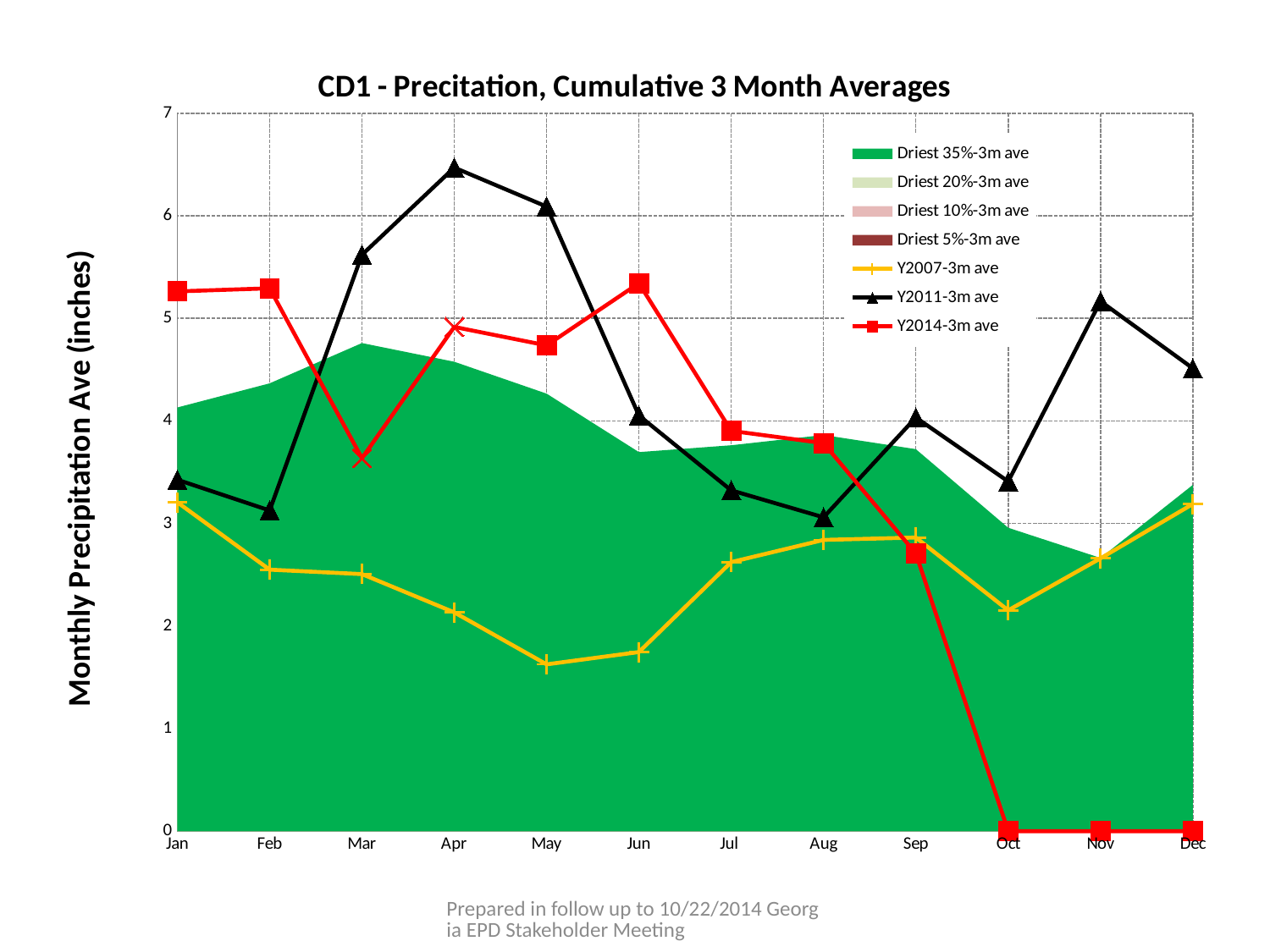
Is the value for Y2011-3m ave in Apr greater or less than 6? greater In Sep, which series has the larger value: Y2011-3m ave or Y2014-3m ave? Y2011-3m ave In Jan, which series has the larger value: Y2014-3m ave or Y2011-3m ave? Y2014-3m ave Is the value for Y2014-3m ave in Jan greater or less than 5? greater Does the Y2014-3m ave series rise or fall from Sep to Oct? fall How many months are shown along the x axis? 12 In which month does the Y2007-3m ave series reach its lowest value? May How many entries does the chart's legend list? 7 What kind of chart is shown on the slide? combination area and line chart What is the title of the chart? CD1 - Precitation, Cumulative 3 Month Averages In which month does the Y2011-3m ave series reach its highest value? Apr Is the value for Y2007-3m ave in May greater or less than 2? less